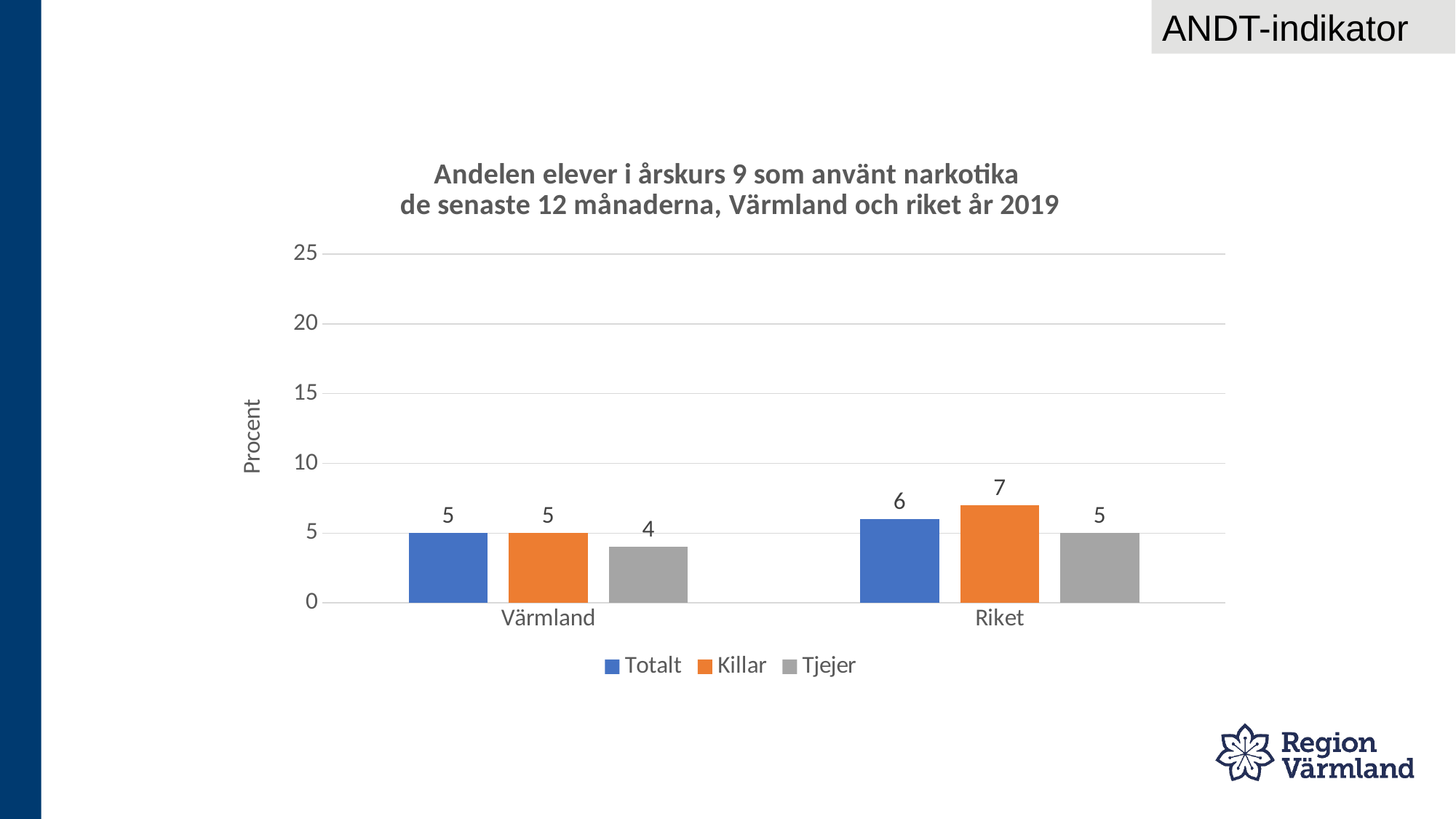
What is the value for Tjejer in Värmland? 4 Which series has the lowest value in Värmland? Tjejer What is the difference between the Killar value in Riket and the Killar value in Värmland? 2 How many series does the legend list? 3 What is the value for Killar in Riket? 7 What kind of chart is shown on the slide? bar chart What is the label of the y axis? Procent What is the value for Totalt in Riket? 6 Which is larger, the Totalt value for Värmland or the Totalt value for Riket? Riket Is the value for Killar in Riket greater or less than 10? less How many categories are shown on the x axis? 2 Which series has the highest value in Riket? Killar